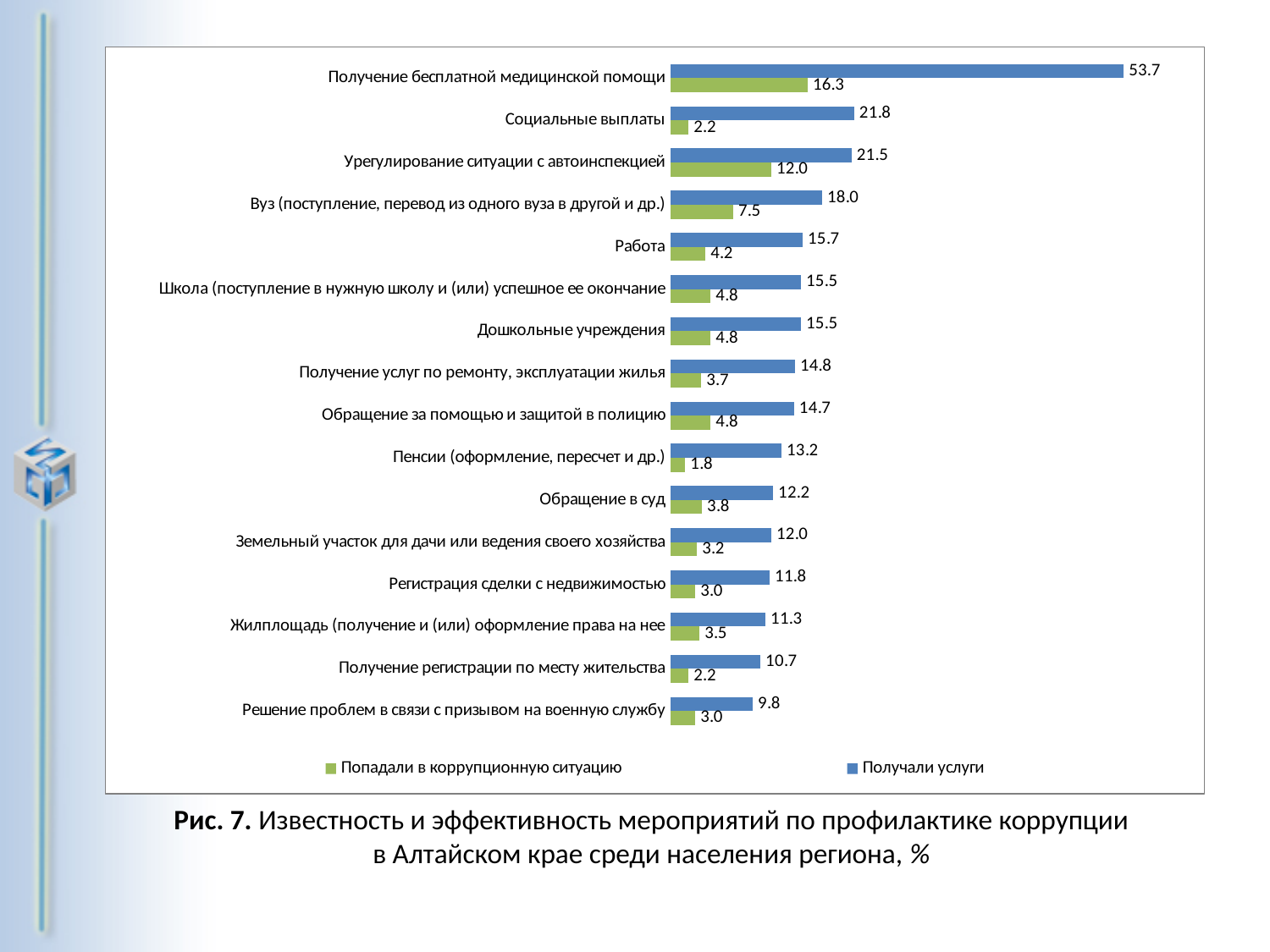
What is the value of "Получали услуги" for "Получение бесплатной медицинской помощи"? 53.7 How many series does the legend list? 2 What is the difference between the "Получали услуги" and "Попадали в коррупционную ситуацию" values for "Урегулирование ситуации с автоинспекцией"? 9.5 Which is larger: the "Получали услуги" value for "Работа" or for "Обращение в суд"? Работа How many categories are shown in the chart? 16 What is the value of "Попадали в коррупционную ситуацию" for "Решение проблем в связи с призывом на военную службу"? 3.0 Which category has the lowest value for "Попадали в коррупционную ситуацию"? Пенсии (оформление, пересчет и др.) What kind of chart is shown on the slide? Bar chart Which category has the lowest value for "Получали услуги"? Решение проблем в связи с призывом на военную службу Which colour represents the series "Получали услуги" in the chart? Blue Which category has the highest value for "Получали услуги"? Получение бесплатной медицинской помощи What is the value of "Попадали в коррупционную ситуацию" for "Социальные выплаты"? 2.2